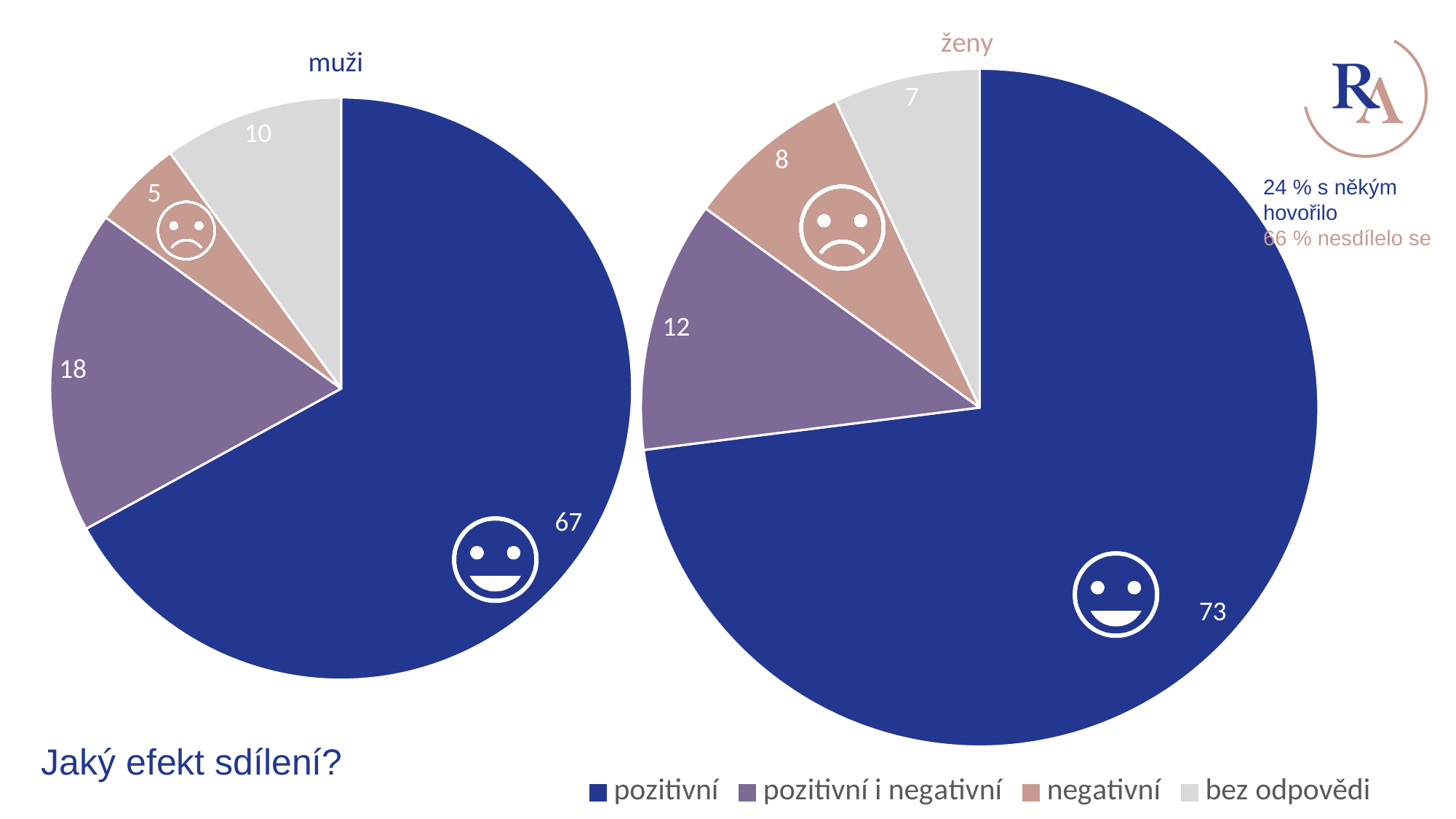
In the "ženy" pie chart, what is the value for "pozitivní i negativní"? 12 In the "ženy" pie chart, which category has the smallest slice? bez odpovědi What type of chart is the "muži" chart? pie chart In the "muži" pie chart, what is the value for "pozitivní"? 67 Which is larger: the "pozitivní i negativní" value in the "muži" chart or in the "ženy" chart? muži How many slices does the "ženy" pie chart have? 4 How many entries does the legend at the bottom of the slide list? 4 In the "muži" pie chart, what is the value for "bez odpovědi"? 10 In the "muži" pie chart, which category has the smallest slice? negativní In the "muži" pie chart, which category has the largest slice? pozitivní In the "ženy" pie chart, what is the value for "negativní"? 8 What is the difference between the "pozitivní" value in the "ženy" chart and the "pozitivní" value in the "muži" chart? 6